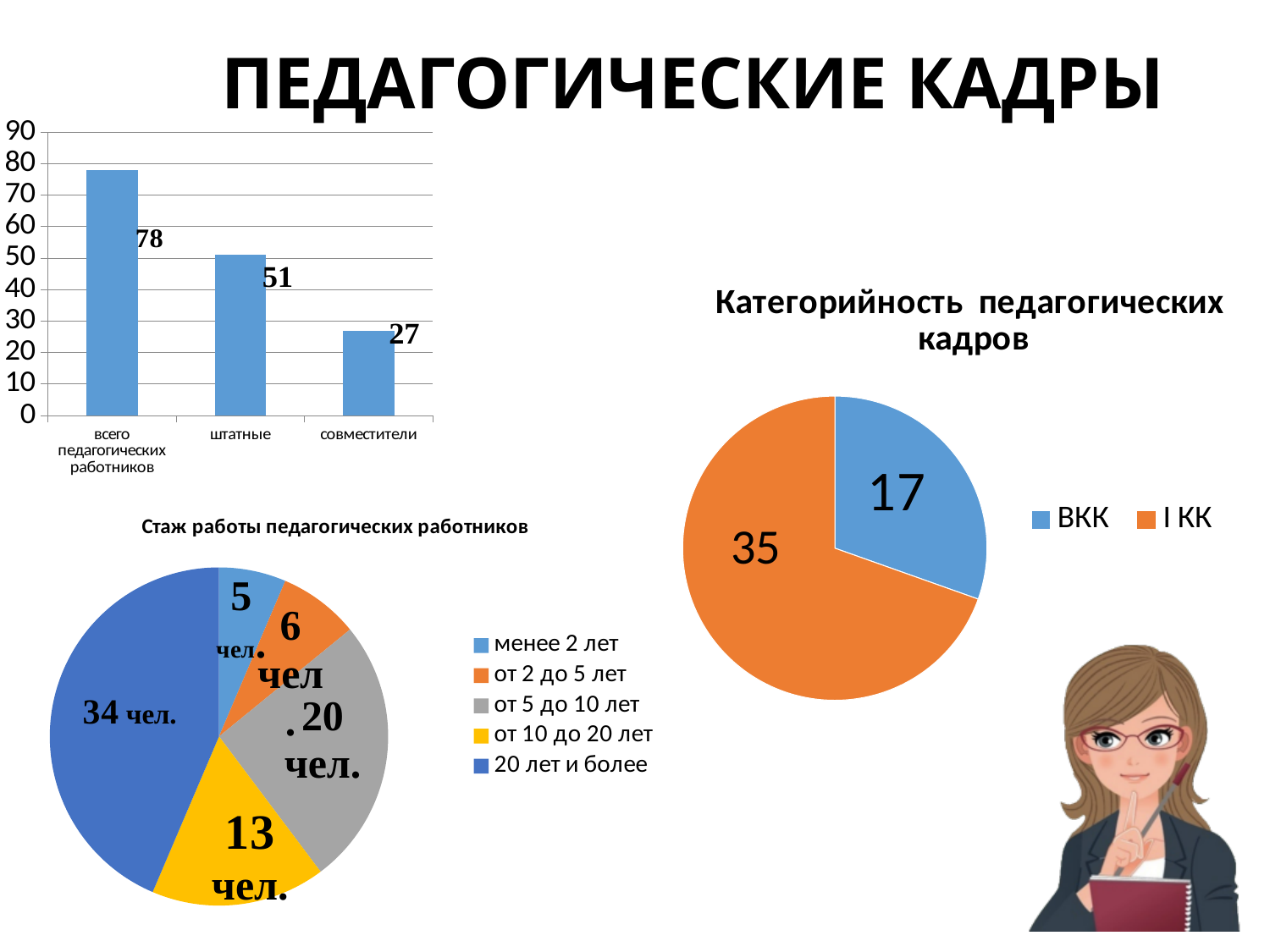
On the pie chart 'Стаж работы педагогических работников', how many categories does the legend list? 5 On the bar chart at the top left, what is the value for штатные? 51 On the pie chart 'Стаж работы педагогических работников', which category has the smallest slice? менее 2 лет On the pie chart 'Категорийность педагогических кадров', what is the value for ВКК? 17 On the pie chart 'Категорийность педагогических кадров', what is the difference between I КК and ВКК? 18 What kind of chart is the chart at the top left of the slide? bar chart On the pie chart 'Стаж работы педагогических работников', what is the value for от 5 до 10 лет? 20 чел. On the bar chart at the top left, what is the difference between всего педагогических работников and штатные? 27 On the bar chart at the top left, how many bars are there? 3 On the pie chart 'Категорийность педагогических кадров', which category is larger, ВКК or I КК? I КК On the bar chart at the top left, which category has the highest value? всего педагогических работников On the bar chart at the top left, what is the value for совместители? 27